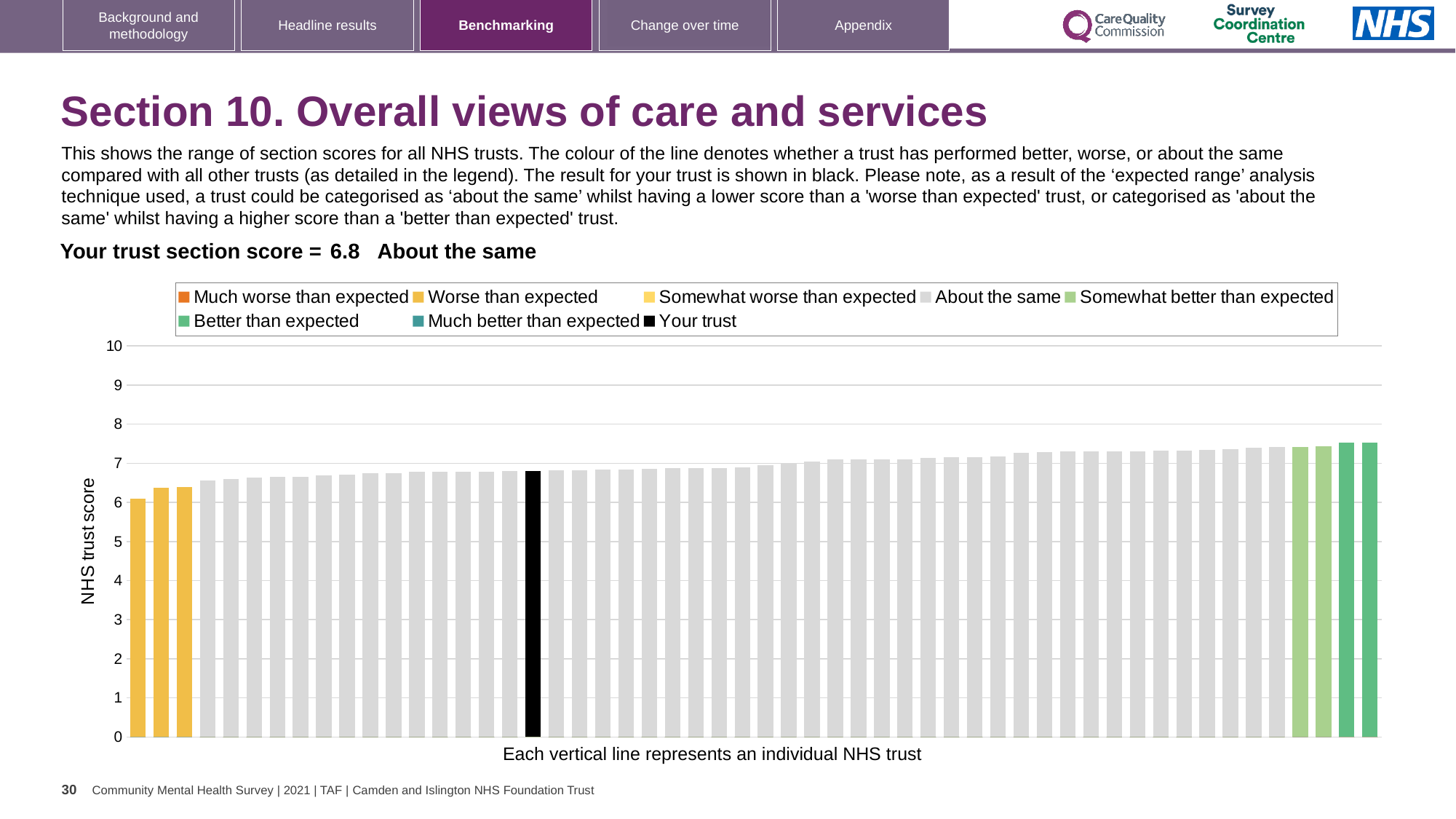
Is the value of the lowest bar in the chart greater or less than 7? less What is the section score for your trust shown on the slide? 6.8 Which category is your trust placed in for this section? About the same What is the title of the vertical axis? NHS trust score Is the value for your trust (the black bar) greater or less than 5? greater What colour is the bar representing your trust? black Do the bar values rise or fall moving from left to right along the x axis? rise How many bars are coloured as 'Better than expected'? 2 How many entries does the chart legend list? 8 What kind of chart is shown on the slide? bar chart Is the value of the highest bar in the chart greater or less than 7? greater How many bars are coloured as 'Worse than expected'? 3